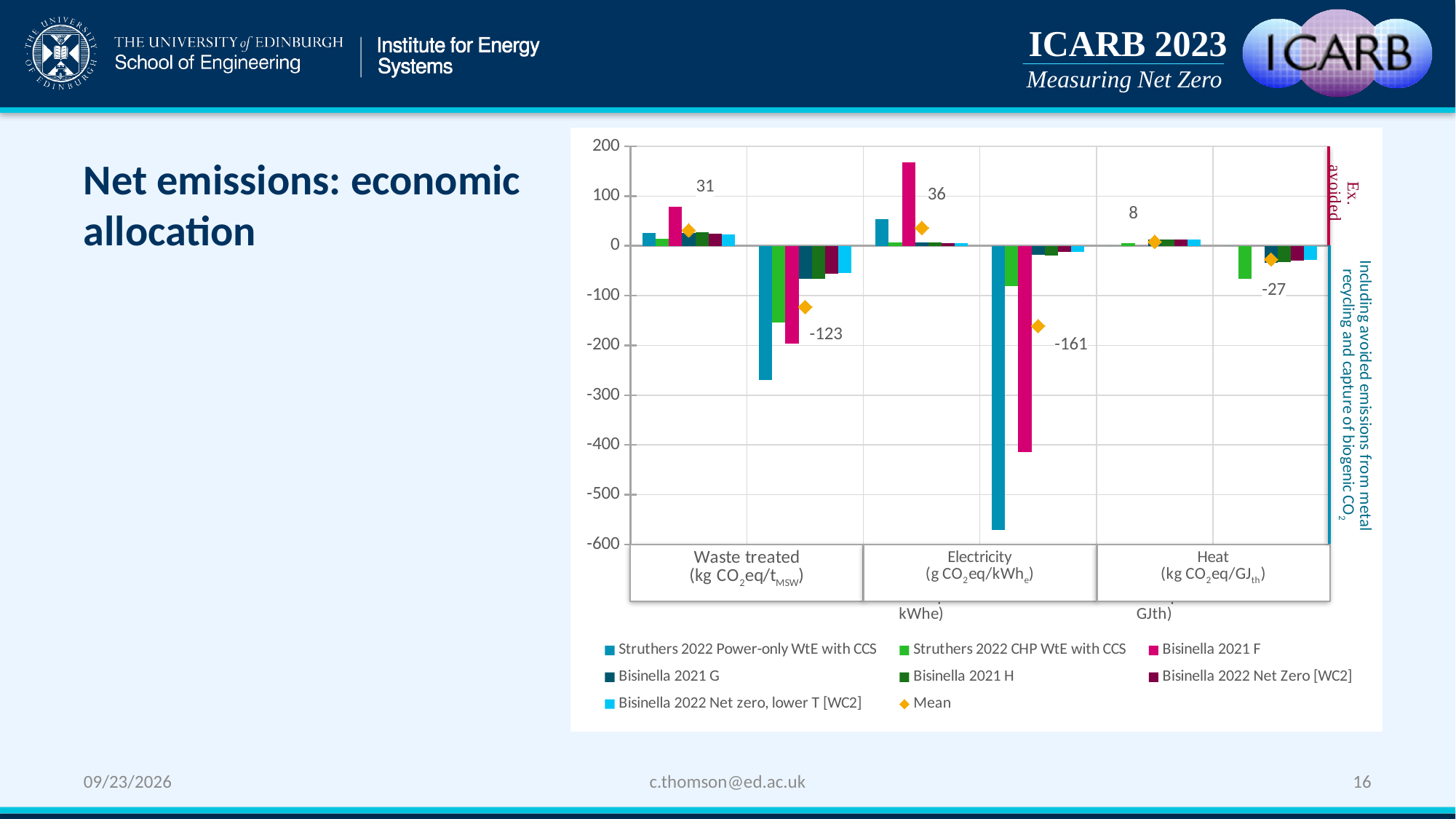
Which labelled Mean value on the chart is the lowest? -161 (Electricity, including avoided emissions) What kind of chart is shown on the slide? Bar chart What is the Mean value labelled for Electricity including avoided emissions? -161 Which is larger, the labelled Mean for Waste treated excluding avoided emissions or the labelled Mean for Heat excluding avoided emissions? Waste treated (31) Is the value for Struthers 2022 Power-only WtE with CCS for Electricity including avoided emissions greater or less than -500? less Is the value for Bisinella 2021 F for Electricity excluding avoided emissions greater or less than 100? greater What is the Mean value labelled for Waste treated including avoided emissions? -123 Which labelled Mean value on the chart is the highest? 36 (Electricity, excluding avoided emissions) What is the difference between the labelled Mean values for Electricity and Waste treated, both excluding avoided emissions? 5 How many entries does the legend list? 8 What is the Mean value labelled for Waste treated excluding avoided emissions? 31 What is the Mean value labelled for Heat including avoided emissions? -27